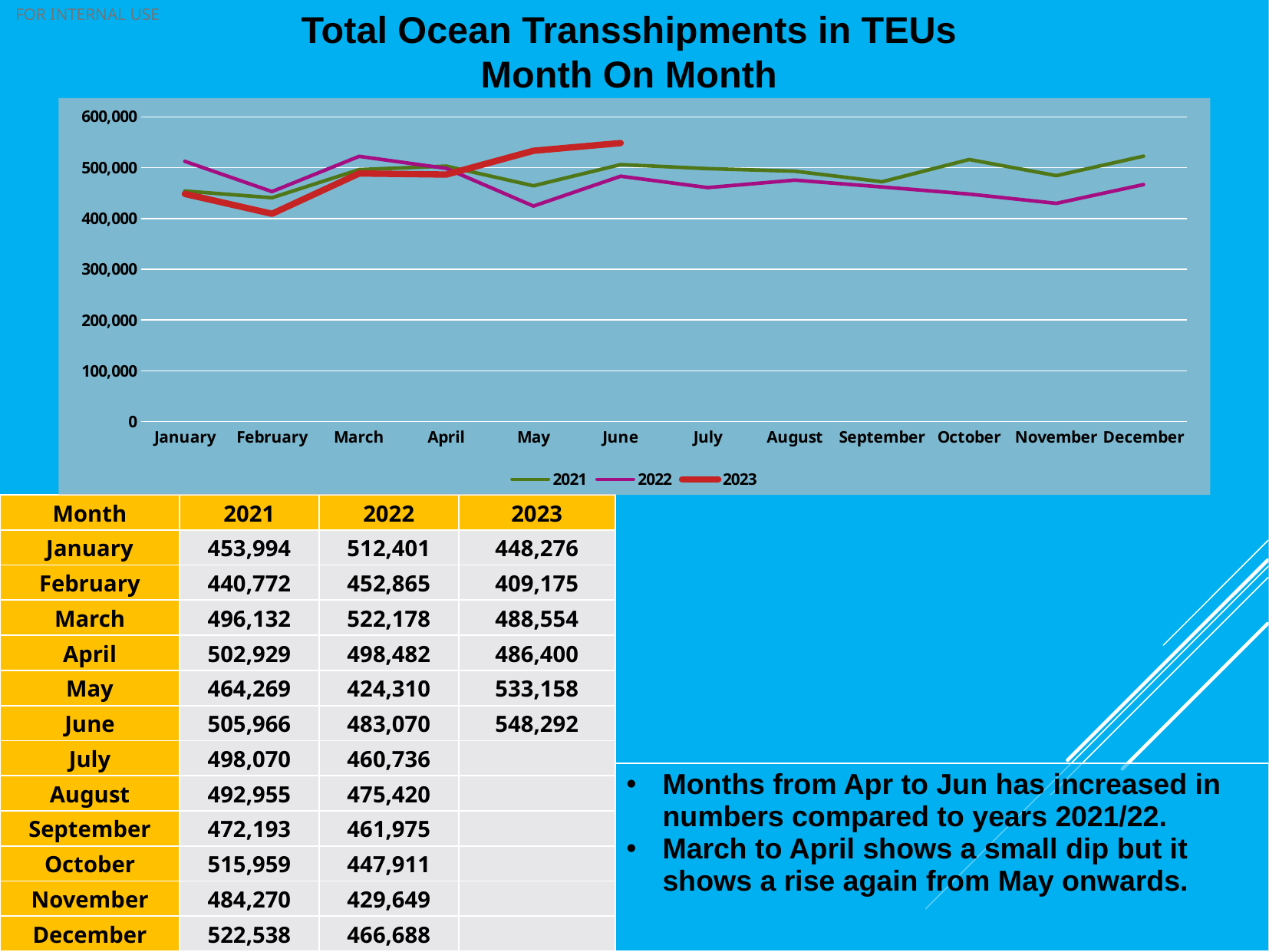
How many series does the chart legend list? 3 Which month has the lowest value in the 2021 series? February What is the difference between the 2023 values for June and May? 15,134 What kind of chart is shown on the slide? line chart What is the value for March in the 2022 series? 522,178 Which month has the highest value in the 2023 series? June What is the value for June in the 2023 series? 548,292 Which is larger, the 2021 value for May or the 2023 value for May? 2023 Is the 2022 value for May greater or less than 500,000? less Does the 2023 series rise or fall from April to June? rise Which month has the lowest value in the 2022 series? May How many months are plotted along the x axis of the chart? 12